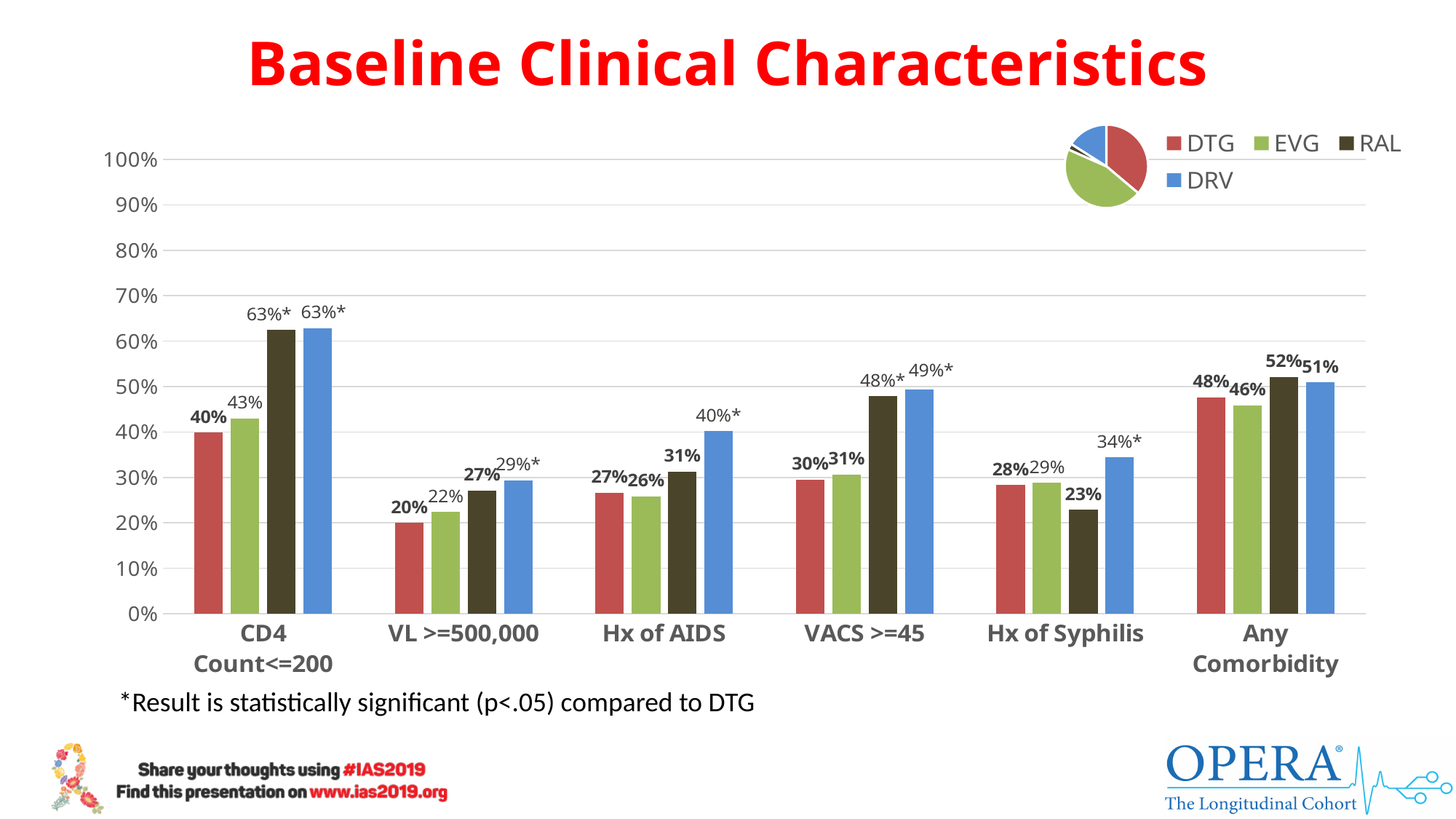
How many categories are shown on the x axis of the bar chart? 6 Which series has the highest value for Any Comorbidity? RAL How many series does the legend list? 4 What is the EVG value for VL >=500,000? 22% What kind of chart is the main chart on the slide? bar chart What is the DTG value for CD4 Count<=200? 40% Which is larger for Hx of Syphilis, the DRV value or the RAL value? DRV What is the RAL value for Hx of Syphilis? 23% What is the title of the slide? Baseline Clinical Characteristics Which series has the lowest value for VL >=500,000? DTG What is the DRV value for Hx of AIDS? 40%* What is the difference between the DRV and DTG values for Hx of AIDS? 13%